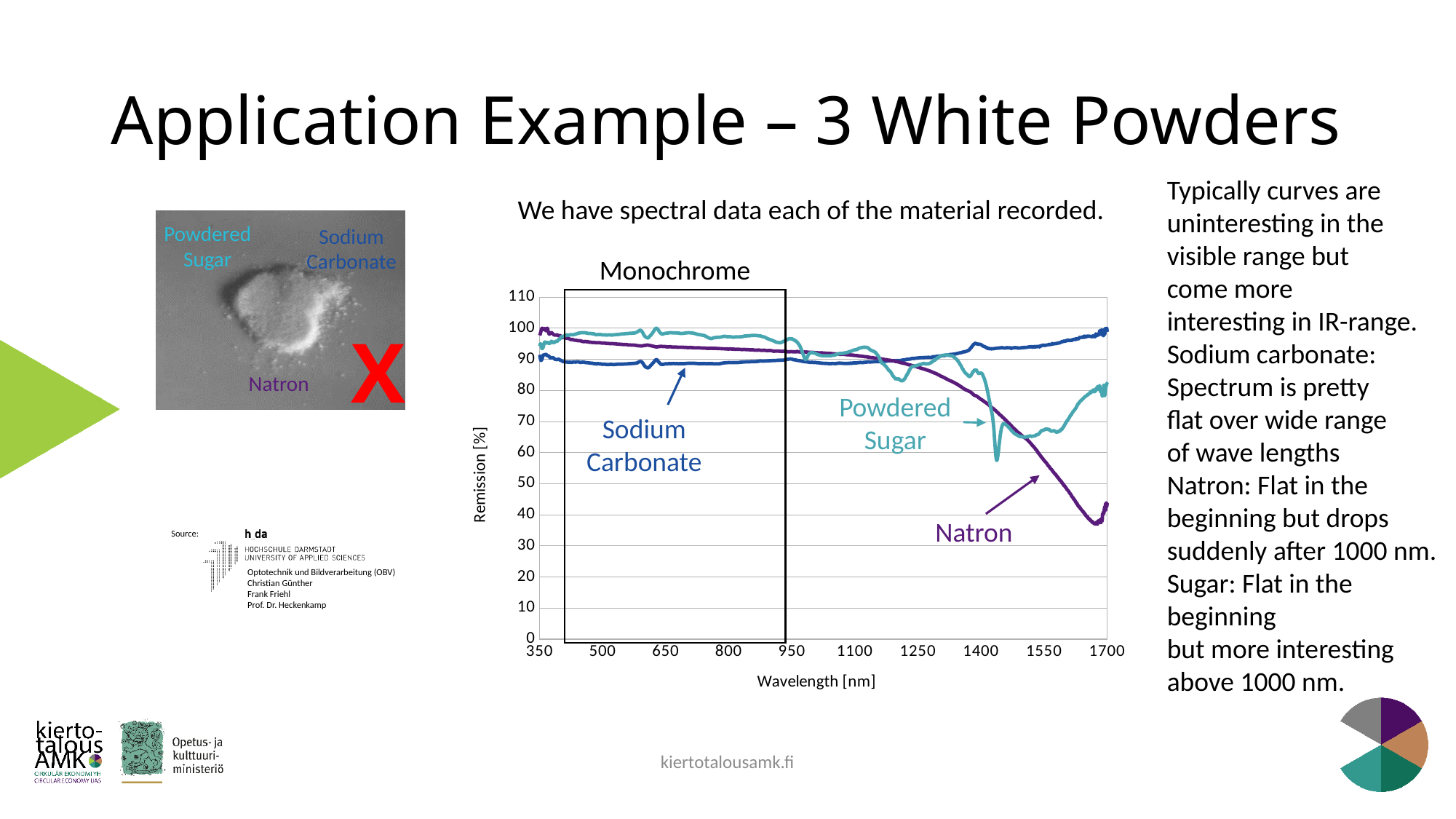
How many material series are plotted on the chart? 3 Which series has the lowest remission at 1700 nm? Natron What is the label of the x axis of the chart? Wavelength [nm] Is the remission value for Natron at 1400 nm greater or less than 70? greater What label is written above the boxed region on the left of the chart? Monochrome What kind of chart is shown on the slide? line chart Is the remission value for Sodium Carbonate at 1700 nm greater or less than 90? greater At 1700 nm, which has the higher remission: Sodium Carbonate or Natron? Sodium Carbonate Which series has the lowest remission at 500 nm? Sodium Carbonate Does the Natron curve rise or fall between 1100 nm and 1650 nm? fall Is the remission value for Natron at 1700 nm greater or less than 50? less